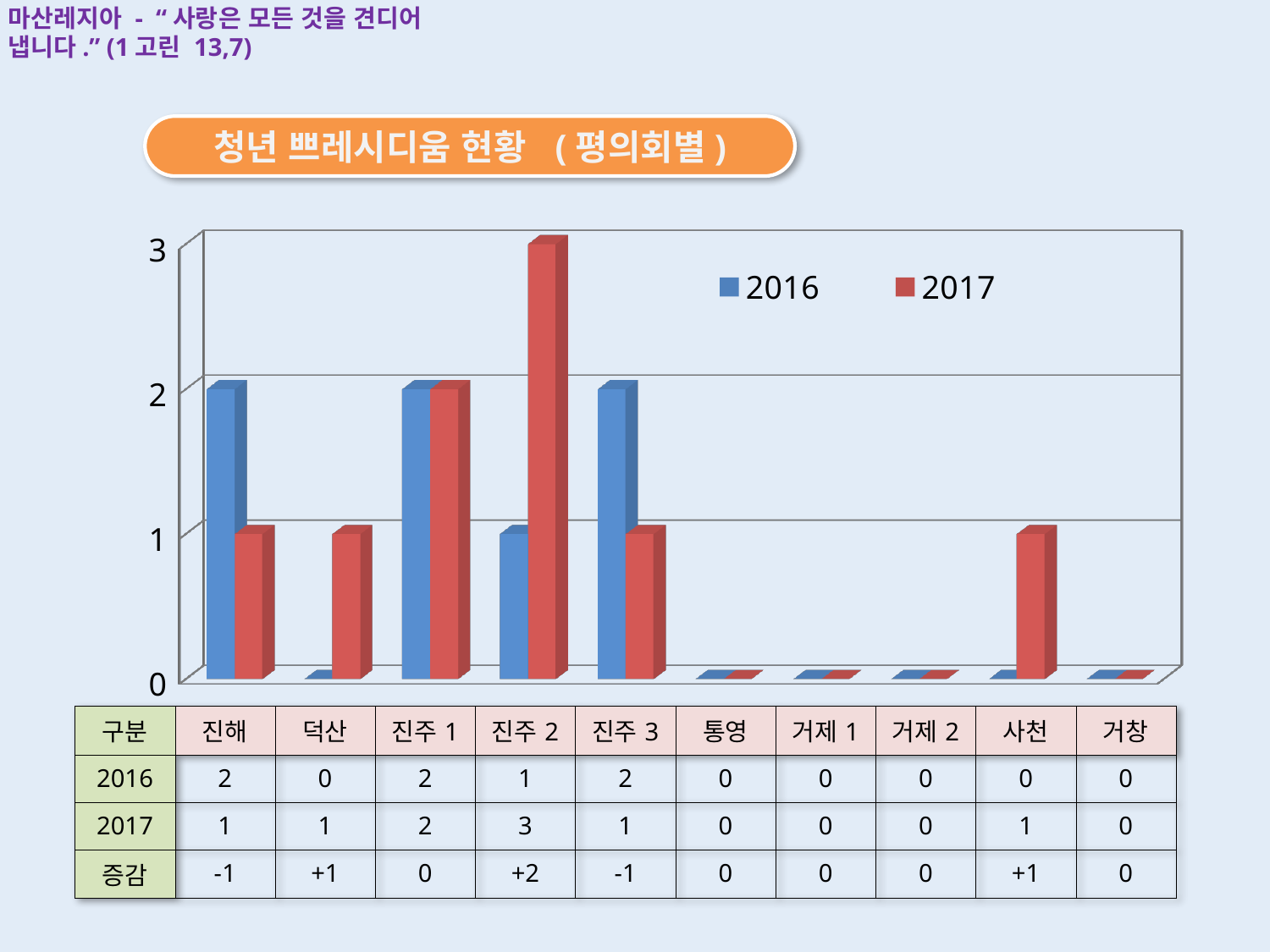
How many categories are shown along the x axis of the chart? 10 What is the 2017 value for 사천? 1 Which series is shown in red in the chart? 2017 What is the difference between the 2016 and 2017 values for 진해? 1 What is the 2017 value for 진주 2? 3 Which category has the highest 2017 value? 진주 2 What is the difference between the 2017 and 2016 values for 진주 2? 2 What is the 2016 value for 덕산? 0 How many series does the chart legend list? 2 What is the 2016 value for 진해? 2 What type of chart is shown on the slide? bar chart Which is larger for 진주 3, the 2016 value or the 2017 value? 2016